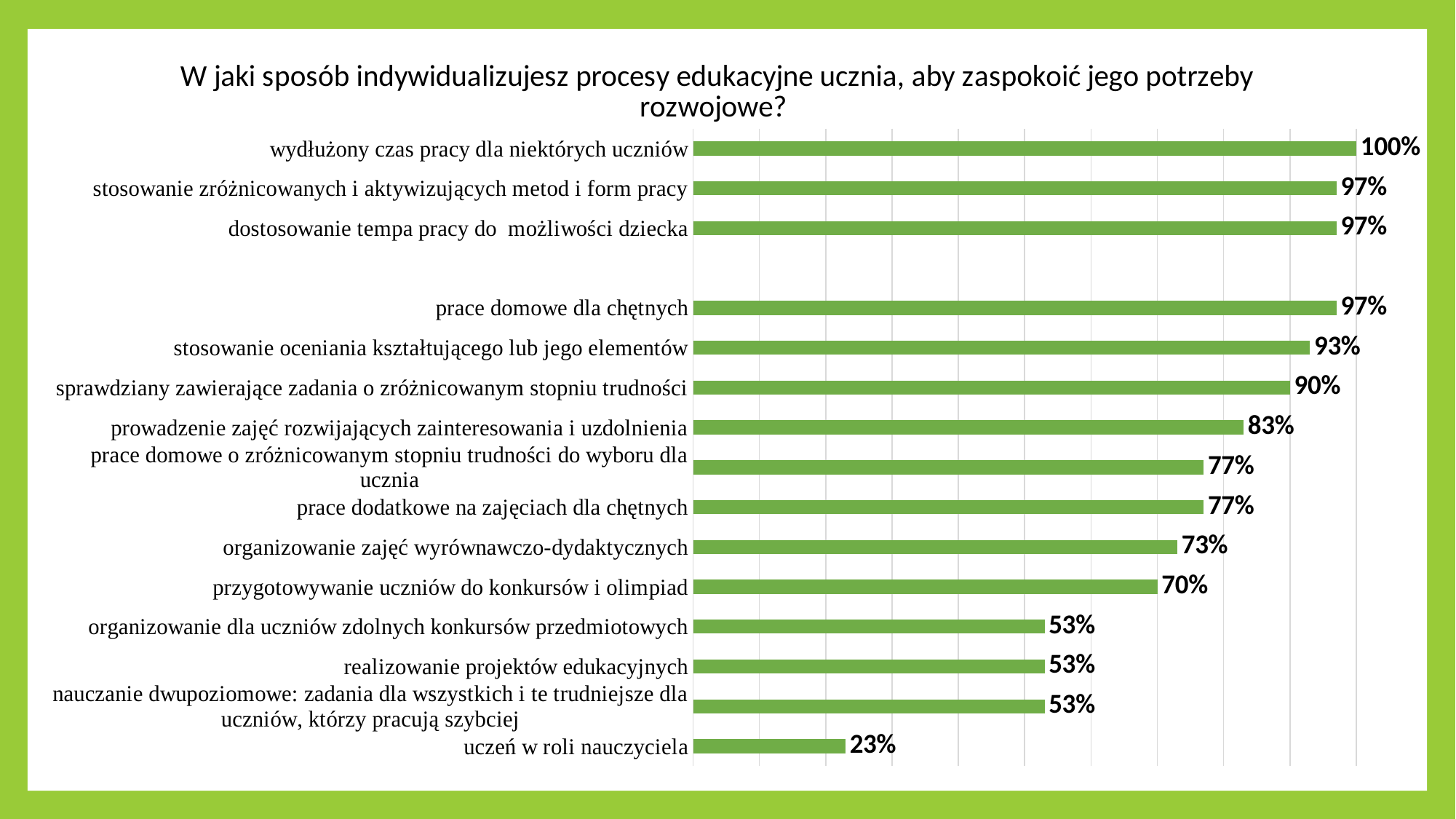
What is the difference between the values for "sprawdziany zawierające zadania o zróżnicowanym stopniu trudności" and "prowadzenie zajęć rozwijających zainteresowania i uzdolnienia"? 7% Which is larger: the value for "realizowanie projektów edukacyjnych" or the value for "przygotowywanie uczniów do konkursów i olimpiad"? przygotowywanie uczniów do konkursów i olimpiad What is the value for "stosowanie oceniania kształtującego lub jego elementów"? 93% What is the value for "organizowanie zajęć wyrównawczo-dydaktycznych"? 73% What is the value for "uczeń w roli nauczyciela"? 23% How many bars are plotted in the chart? 15 What kind of chart is shown on the slide? bar chart What is the difference between the values for "wydłużony czas pracy dla niektórych uczniów" and "uczeń w roli nauczyciela"? 77% What is the value for "przygotowywanie uczniów do konkursów i olimpiad"? 70% Which category has the lowest value? uczeń w roli nauczyciela What is the value for "wydłużony czas pracy dla niektórych uczniów"? 100% Which category has the highest value? wydłużony czas pracy dla niektórych uczniów